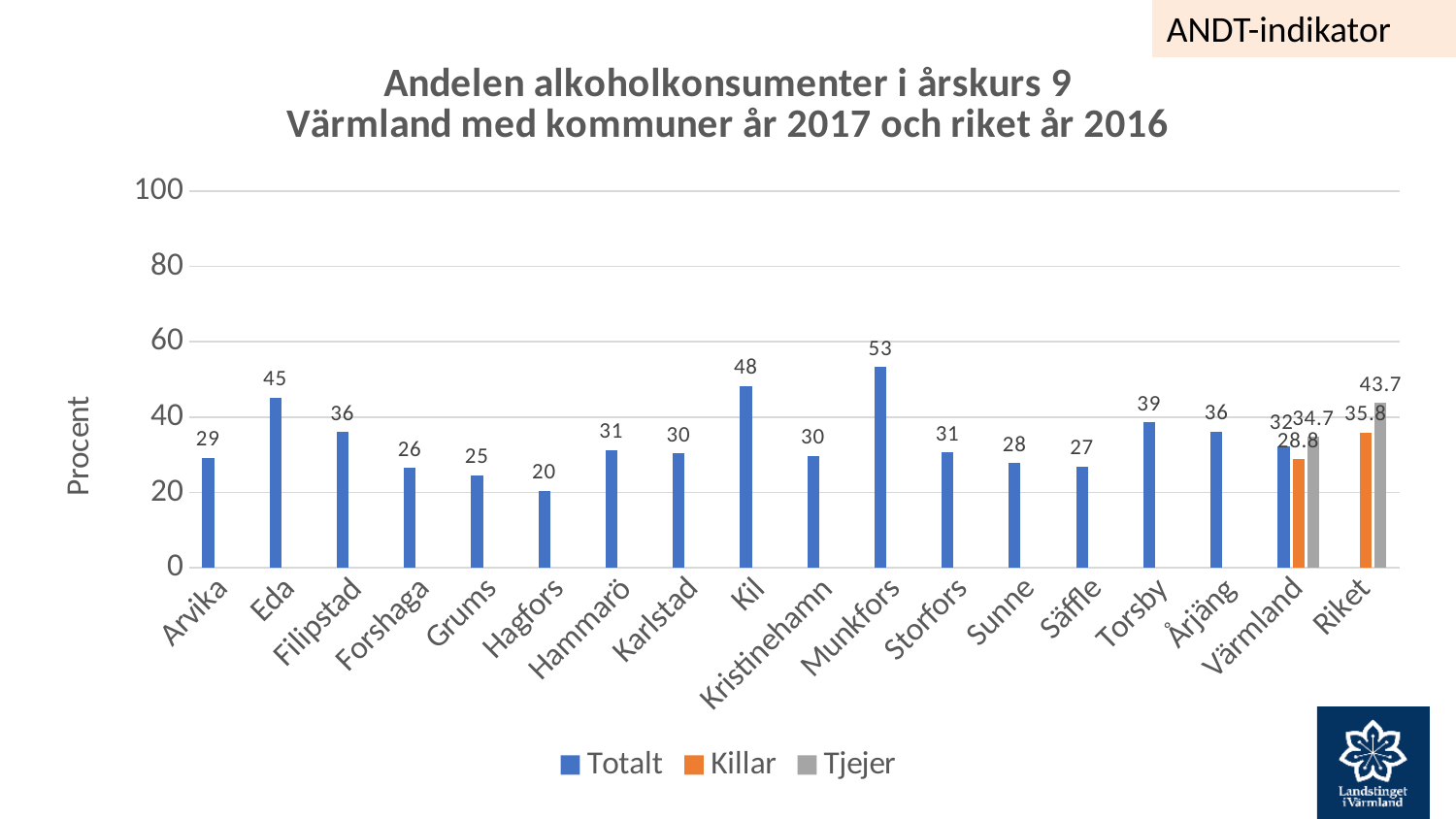
Which category has the lowest Totalt value? Hagfors How many categories are shown on the x axis? 18 What is the Tjejer value for Riket? 43.7 What is the Totalt value for Munkfors? 53 What is the difference between the Tjejer and Killar values for Riket? 7.9 Is the Totalt value for Hagfors greater or less than 40? less What kind of chart is shown on the slide? bar chart Which category has the highest Totalt value? Munkfors How many series does the legend list? 3 What is the Killar value for Värmland? 28.8 Which has a larger Totalt value, Kil or Torsby? Kil What is the difference between the Totalt values for Eda and Arvika? 16